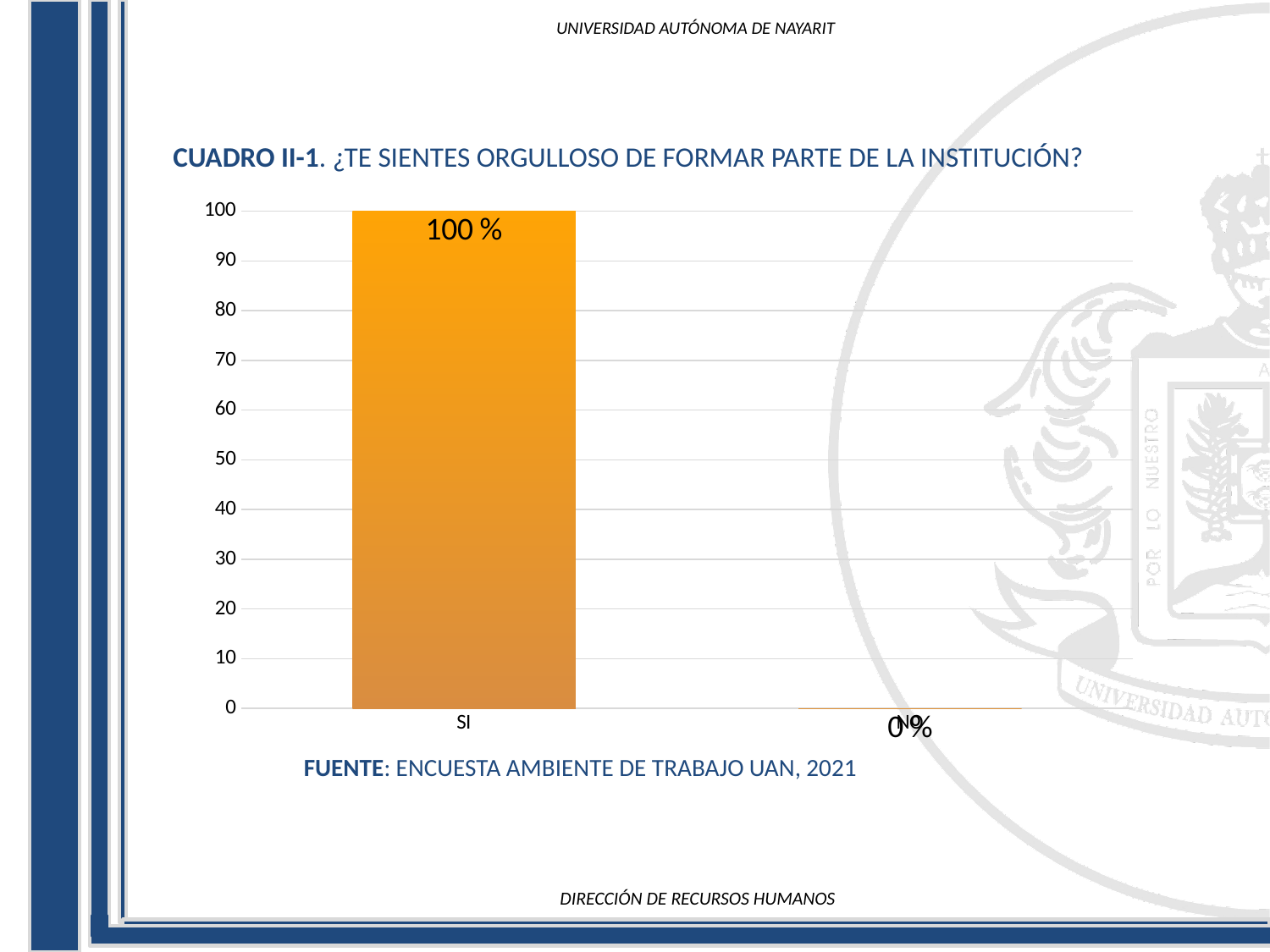
What is the maximum value shown on the vertical axis? 100 What is the value shown for NO? 0% What source is cited below the chart? ENCUESTA AMBIENTE DE TRABAJO UAN, 2021 What is the value shown for SI? 100 % How many categories are shown on the x axis? 2 Which category has the lowest value? NO Which is larger, the value for SI or the value for NO? SI Is the value for SI greater or less than 50? greater Which category has the highest value? SI What kind of chart is shown on the slide? bar chart What is the difference between the values for SI and NO? 100 %